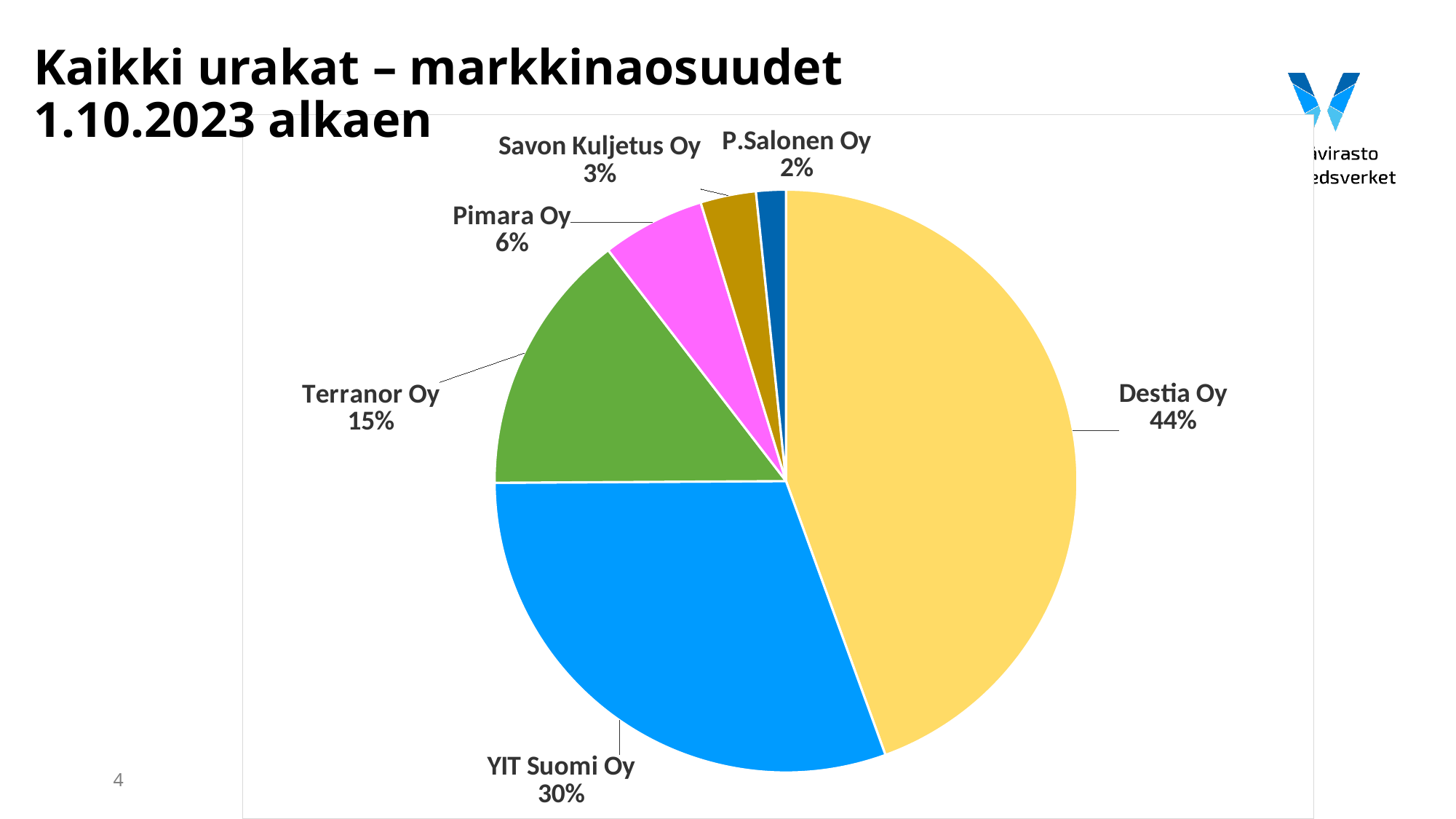
How many companies are shown in the pie chart? 6 Which company has the largest market share? Destia Oy What is the difference in market share between Destia Oy and YIT Suomi Oy? 14% Which company has the smallest market share? P.Salonen Oy What is the market share of Terranor Oy? 15% What is the market share of YIT Suomi Oy? 30% What is the market share of Savon Kuljetus Oy? 3% What kind of chart is shown on the slide? pie chart What is the market share of Destia Oy? 44% What is the market share of Pimara Oy? 6% Which has a larger market share, Terranor Oy or Pimara Oy? Terranor Oy What colour is the slice for YIT Suomi Oy? blue